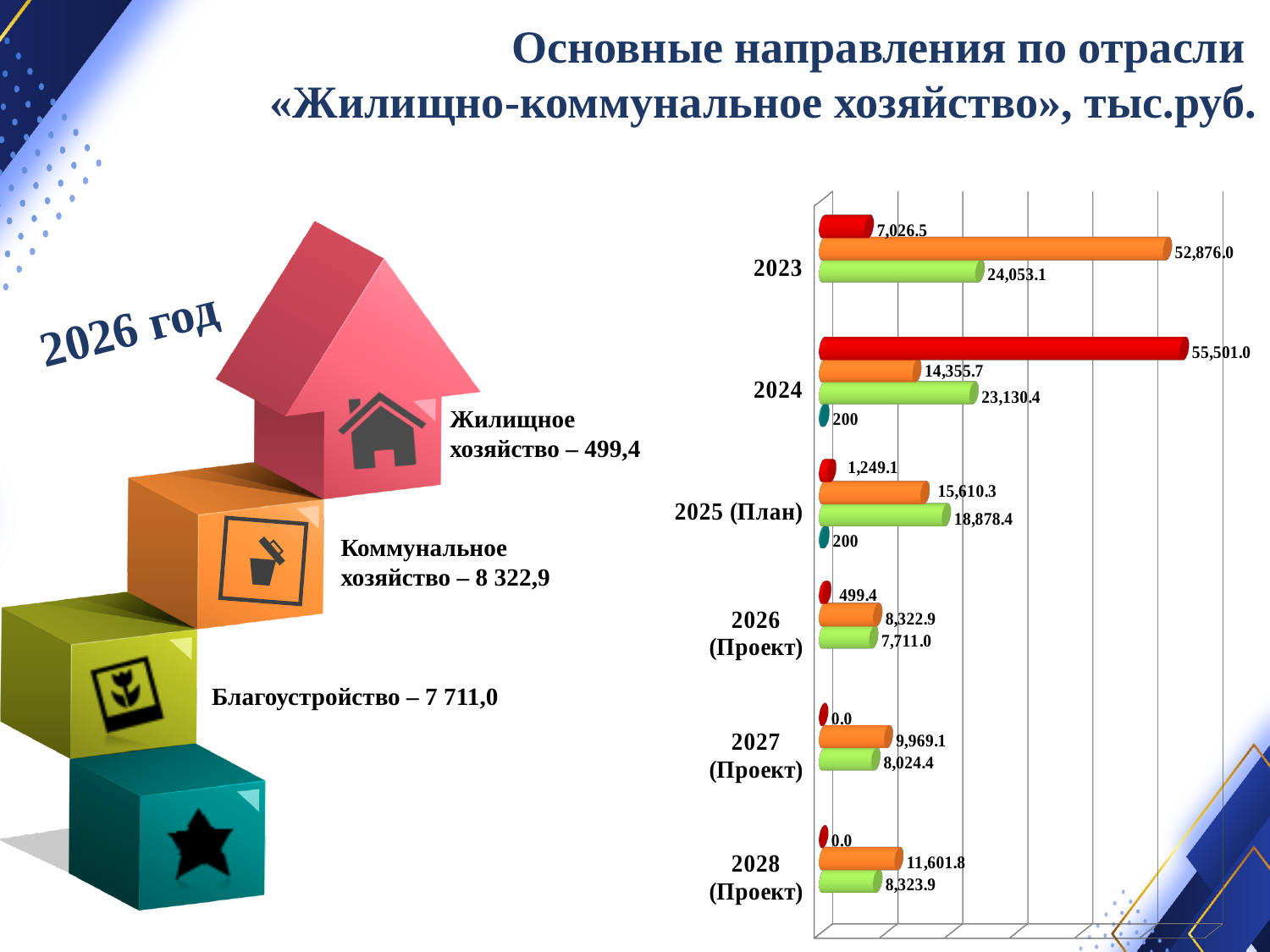
What type of chart is shown on the slide? bar chart What is the difference between the red bar and the orange bar for 2024? 41,145.3 What is the value of the green bar for 2025 (План)? 18,878.4 For 2025 (План), which is larger: the orange bar or the green bar? the green bar (18,878.4) How many year categories are shown on the chart? 6 In which year is the green bar the lowest? 2026 (Проект) What is the value of the red bar for 2024? 55,501.0 Does the orange bar rise or fall from 2026 (Проект) to 2028 (Проект)? rises What is the value of the red bar for 2027 (Проект)? 0.0 In which year is the orange bar the highest? 2023 What is the difference between the orange bar and the green bar for 2023? 28,822.9 What is the value of the orange bar for 2023? 52,876.0